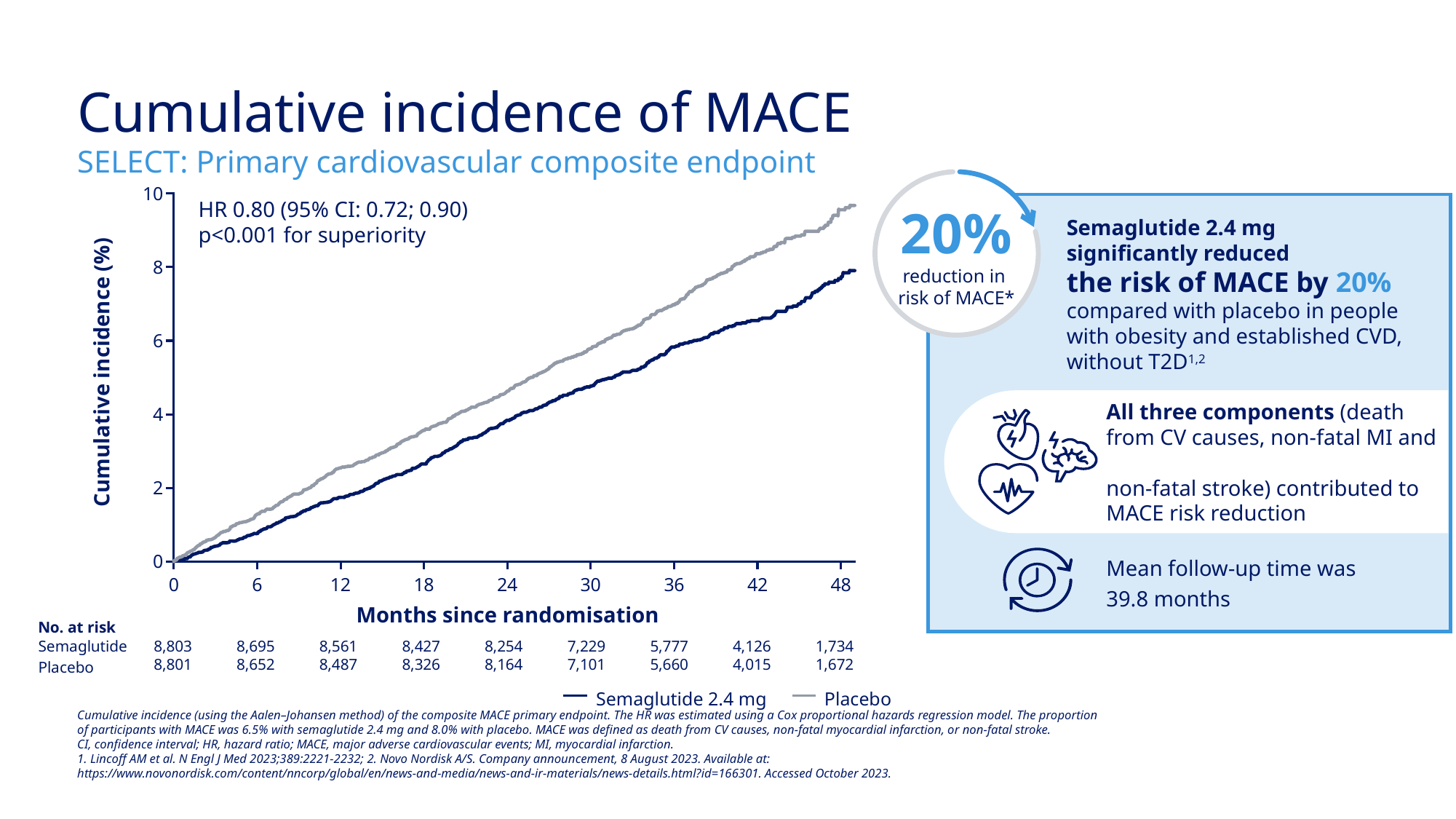
What is the difference between the number of Semaglutide and Placebo participants at risk at month 36? 117 How many series does the chart legend list? 2 According to the 'No. at risk' table, how many Placebo participants were at risk at month 48? 1,672 What hazard ratio is printed on the chart? HR 0.80 (95% CI: 0.72; 0.90) Is the cumulative incidence for Placebo at 48 months greater or less than 8%? greater At 48 months, which series has the higher cumulative incidence, Semaglutide 2.4 mg or Placebo? Placebo Which two series are shown in the chart legend? Semaglutide 2.4 mg and Placebo Is the cumulative incidence for Placebo at 24 months greater or less than 4%? greater What kind of chart is shown on the slide? Line chart Do the cumulative incidence curves rise or fall as months since randomisation increase? Rise According to the 'No. at risk' table, how many Semaglutide participants were at risk at month 0? 8,803